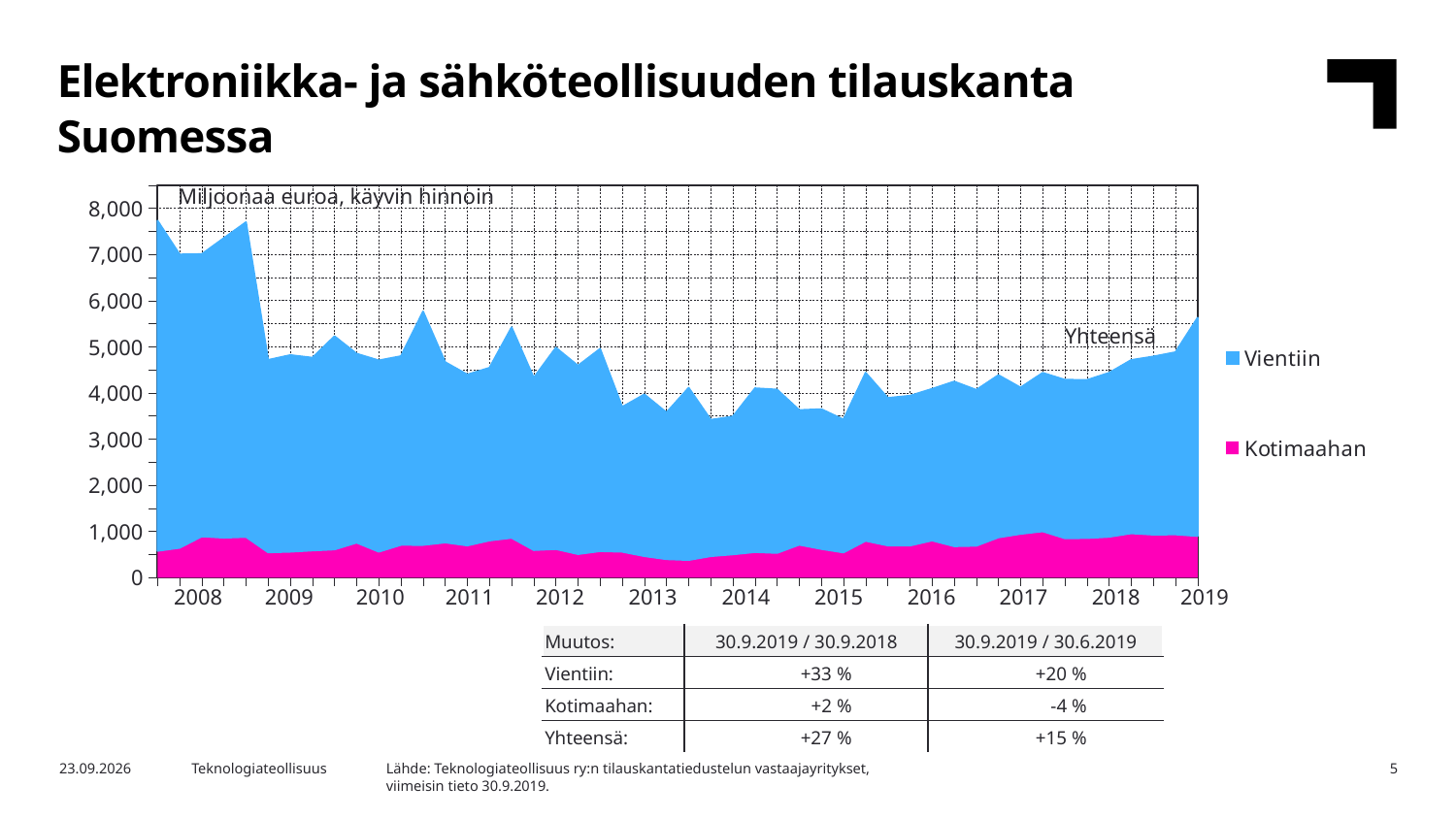
How many year labels are shown on the x axis? 12 Is the total (Yhteensä) at the start of 2008 greater or less than 7,000? greater Is the total (Yhteensä) at the end of 2019 greater or less than 5,000? greater In which year does the total (Yhteensä) reach its highest level on the chart? 2008 What unit is stated at the top of the chart? Miljoonaa euroa, käyvin hinnoin How many series does the chart legend list? 2 What kind of chart is shown on the slide? Stacked area chart What are the two series named in the chart legend? Vientiin and Kotimaahan Is the total (Yhteensä) in 2014 greater or less than 5,000? less Which series is larger throughout the chart, Vientiin or Kotimaahan? Vientiin Does the total order book rise or fall between 2008 and 2009? fall